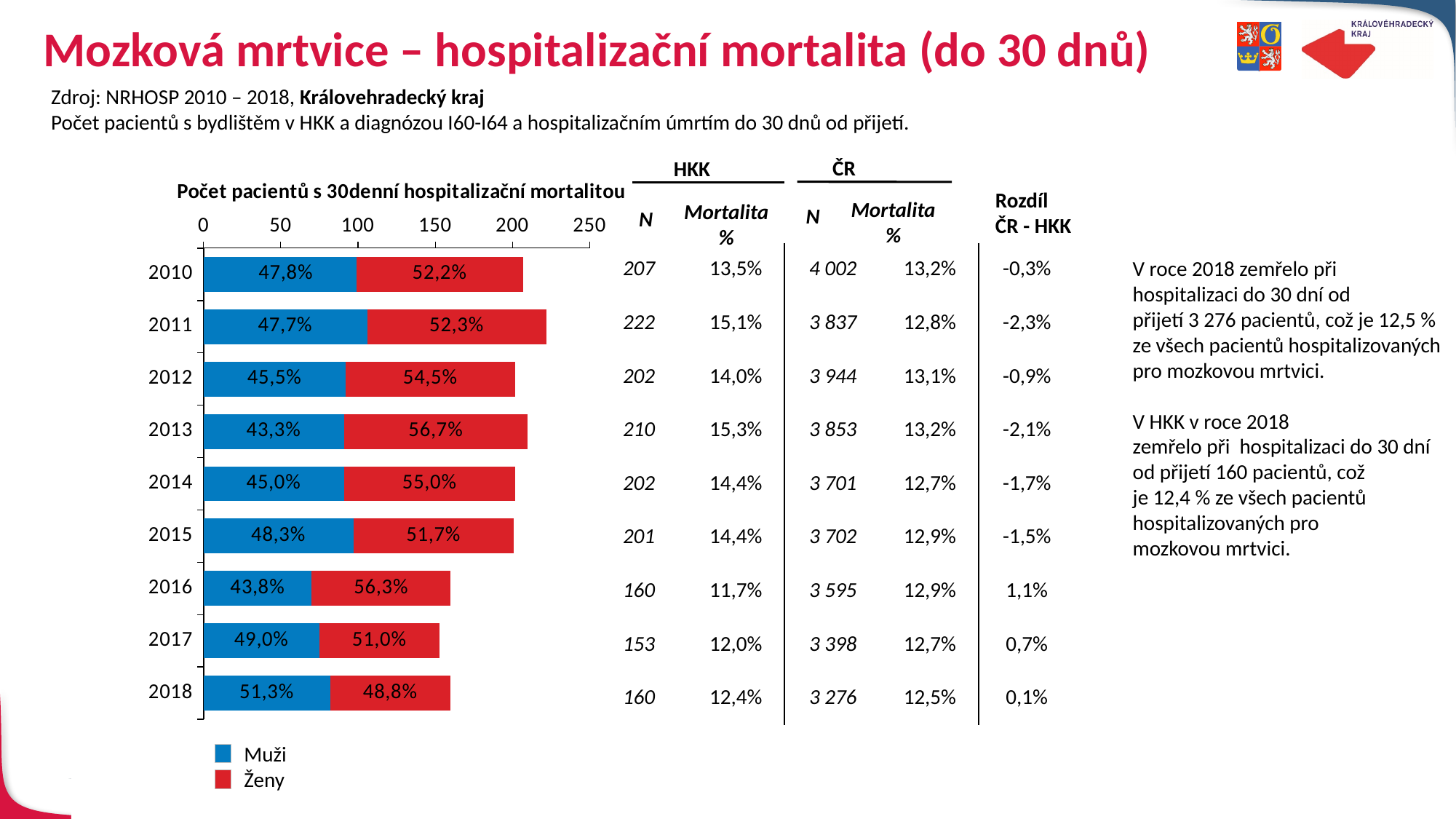
What is the Muži share shown on the bar for 2010? 47,8% What is the Ženy share shown on the bar for 2013? 56,7% Is the total length of the bar for 2011 greater or less than 200? greater What is the difference between the Ženy and Muži shares in 2012? 9,0% How many years (bars) does the chart show? 9 Is the total length of the bar for 2016 greater or less than 200? less What is the Ženy share shown on the bar for 2017? 51,0% What kind of chart is shown on the slide? Stacked horizontal bar chart In which year is the Ženy share the highest? 2013 In 2018, which segment has the larger share, Muži or Ženy? Muži How many series does the chart legend list? 2 In which year is the Muži share the lowest? 2013